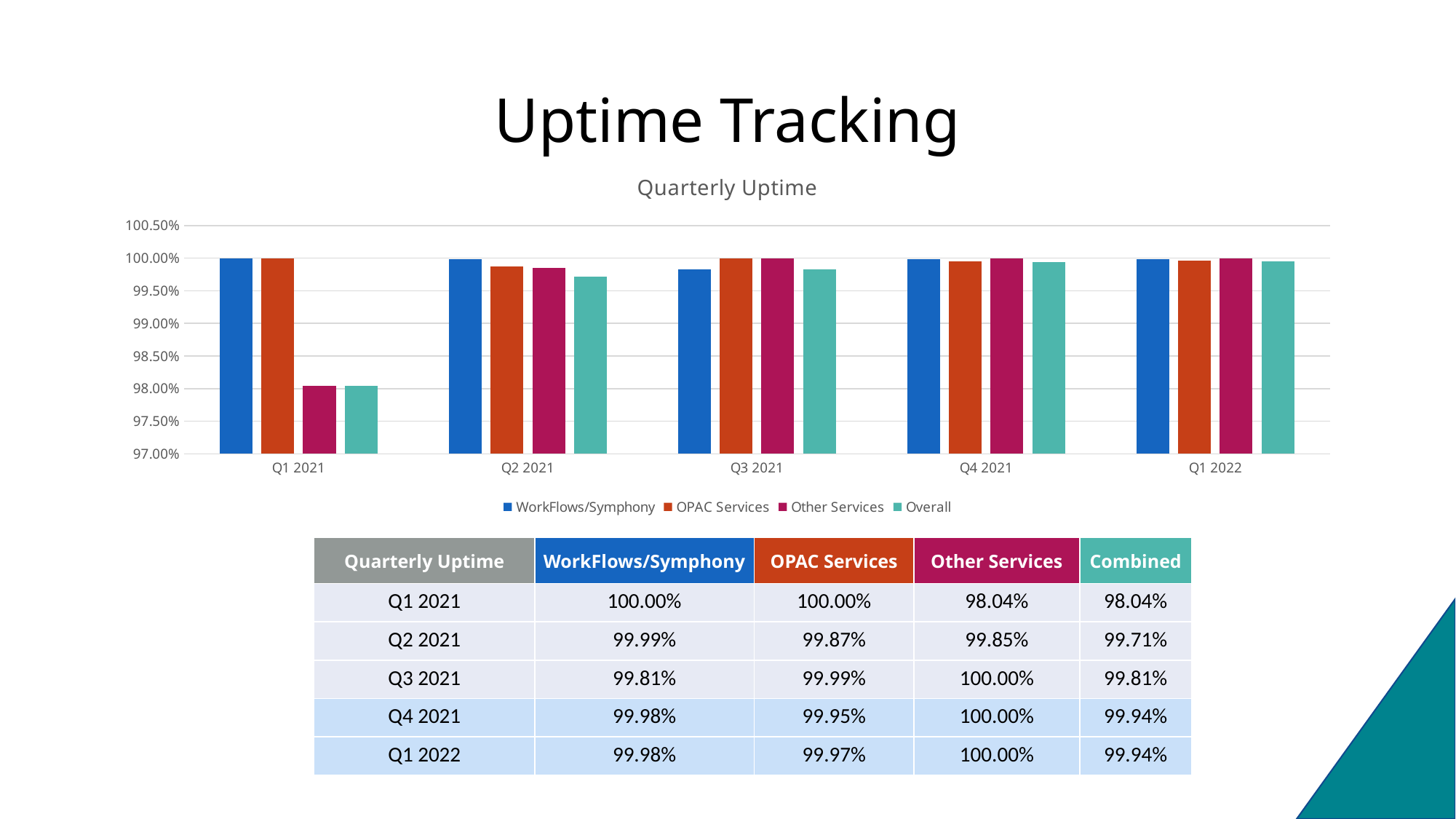
How many series does the chart legend list? 4 What type of chart is shown on the slide? bar chart What is the title of the chart? Quarterly Uptime Which quarter has the lowest Overall uptime? Q1 2021 How many quarters are shown on the x axis of the chart? 5 Which quarter has the lowest WorkFlows/Symphony uptime? Q3 2021 What is the Other Services uptime for Q1 2021? 98.04% What is the difference between the OPAC Services uptime and the Other Services uptime in Q1 2021? 1.96% What is the WorkFlows/Symphony uptime for Q3 2021? 99.81% Is the Other Services value for Q1 2021 greater or less than 99.00%? less What is the Overall uptime for Q2 2021? 99.71% In Q2 2021, which is larger: the WorkFlows/Symphony uptime or the Overall uptime? WorkFlows/Symphony